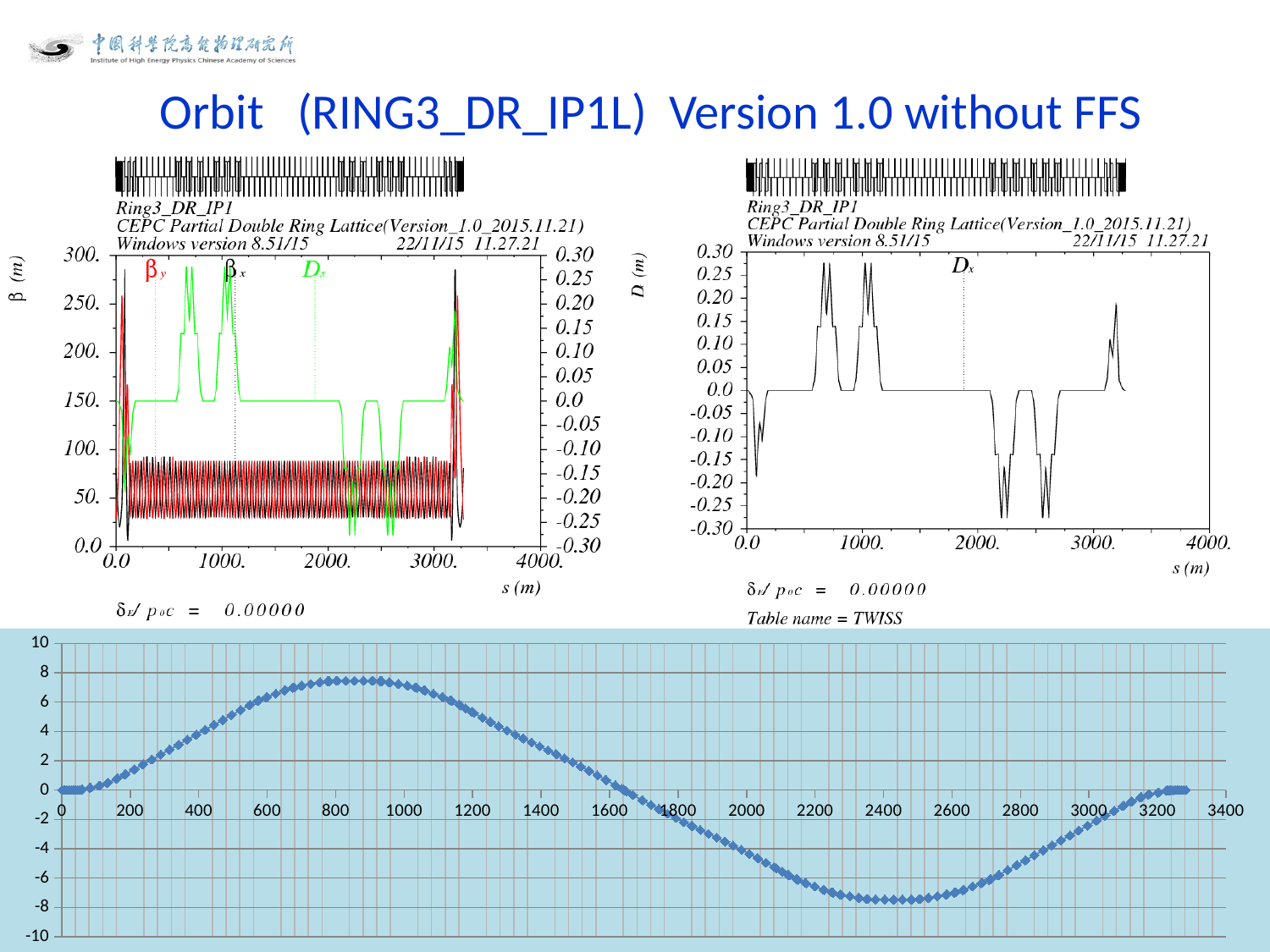
On the bottom chart, what is the highest tick value shown on the vertical axis? 10 On the bottom chart, do the values rise or fall as x goes from 1000 to 2400? fall On the bottom chart, which is larger: the value at x = 800 or the value at x = 2400? the value at x = 800 On the bottom chart, do the values rise or fall as x goes from 0 to 800? rise On the top-left chart (β (m) versus s (m)), is the peak β value near s = 3200 greater or less than 250? greater On the bottom chart, is the value at x = 2400 greater or less than -6? less How many series are labelled on the top-left chart (β (m) versus s (m))? 3 On the top-right chart (D (m) versus s (m)), is the peak value near s = 700 greater or less than 0.20? greater On the bottom chart, what is the largest tick value shown on the horizontal axis? 3400